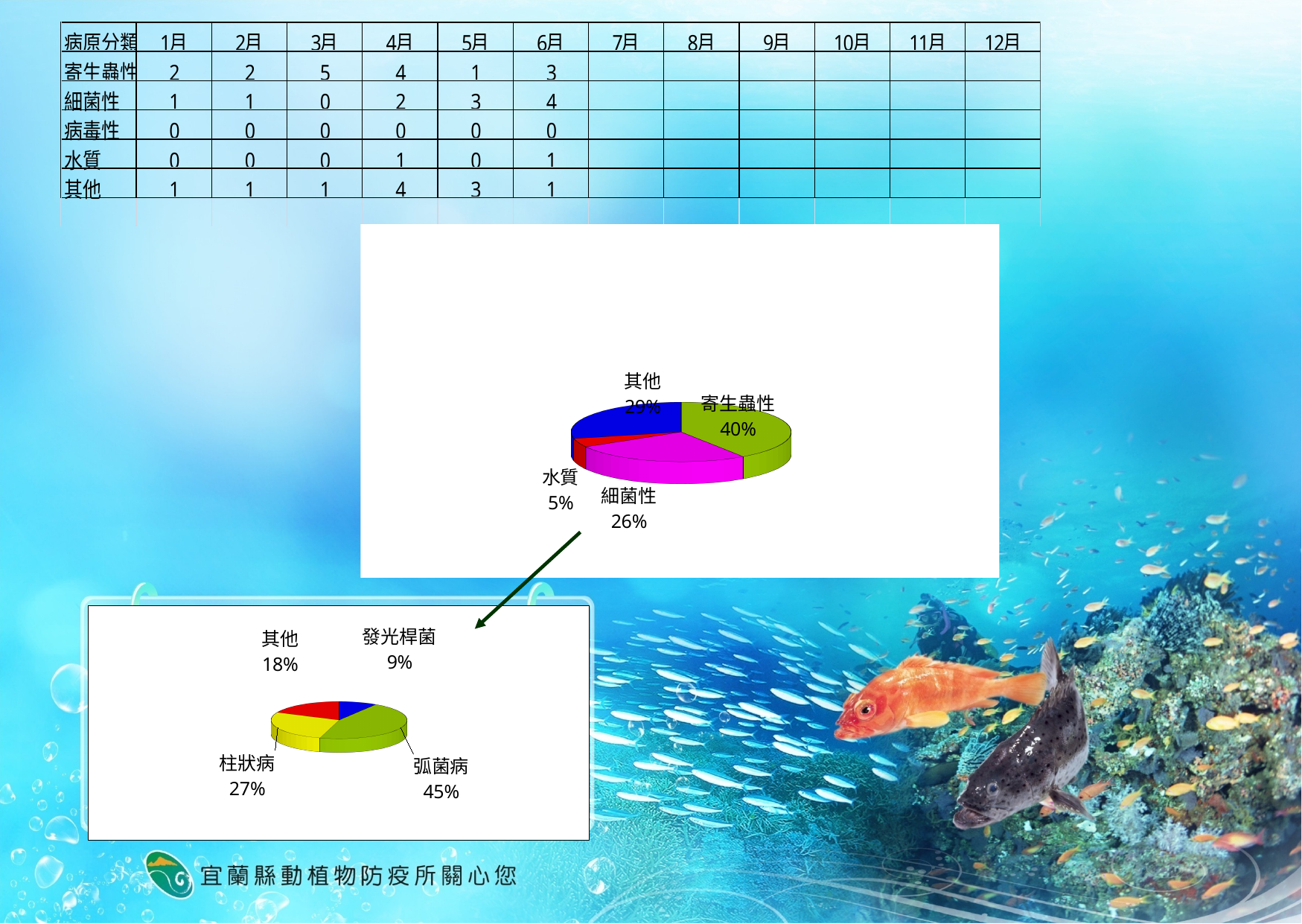
In the lower-left pie chart, which is larger, 柱狀病 or 其他? 柱狀病 In the upper pie chart, how many slices are shown? 4 In the upper pie chart, which category has the largest share? 寄生蟲性 In the lower-left pie chart, what share does 發光桿菌 have? 9% In the lower-left pie chart, what is the difference in percentage points between 弧菌病 and 柱狀病? 18 What type of chart is the upper chart? pie chart In the lower-left pie chart, which category has the largest share? 弧菌病 In the upper pie chart, which category has the smallest share? 水質 In the upper pie chart, what share does 寄生蟲性 have? 40% In the upper pie chart, what is the difference in percentage points between 其他 and 水質? 24 In the upper pie chart, what share does 細菌性 have? 26% In the lower-left pie chart, what share does 弧菌病 have? 45%